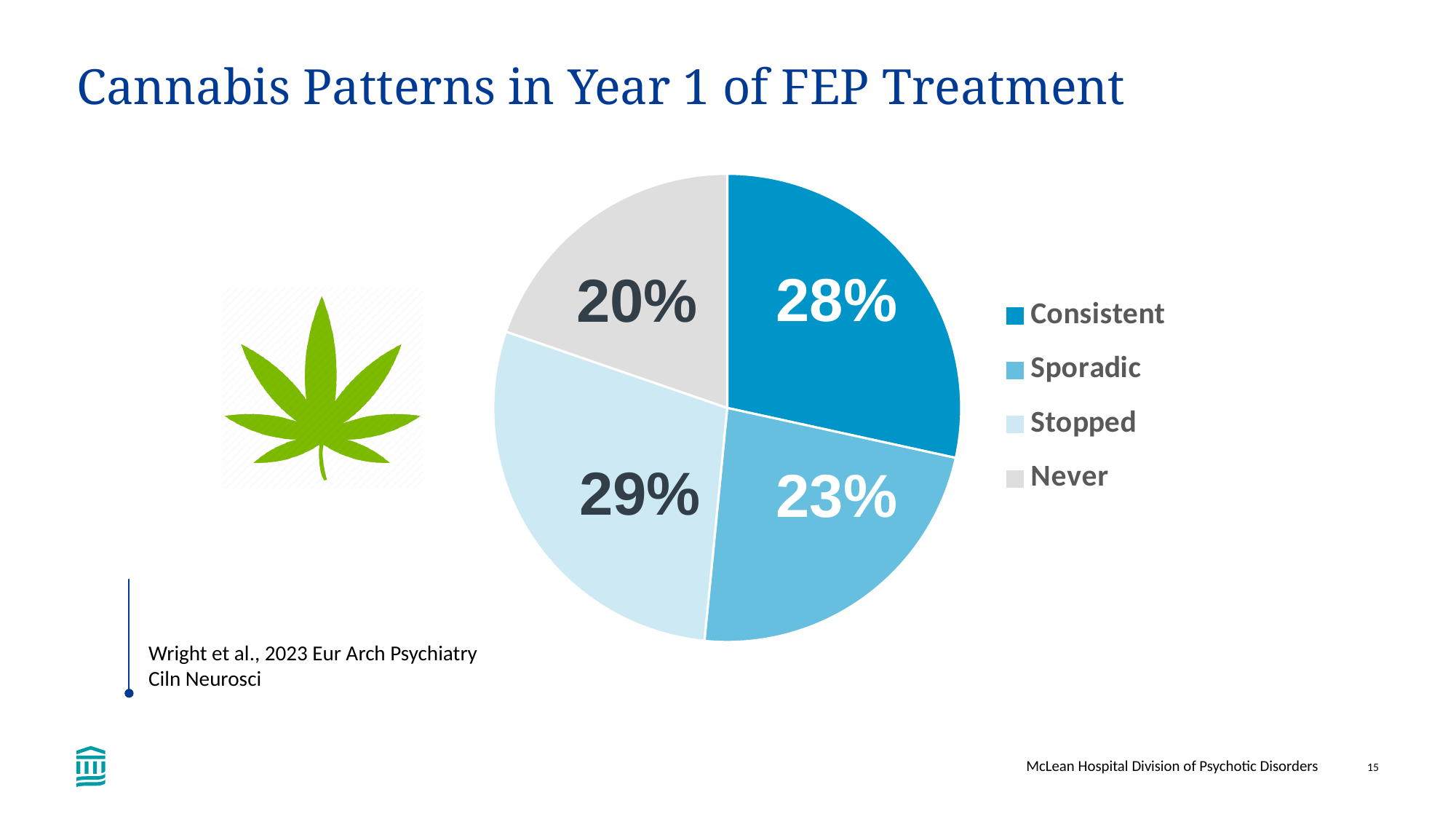
What percentage of the pie is labelled Consistent? 28% How many slices does the pie chart have? 4 What kind of chart is shown on the slide? Pie chart What percentage of the pie is labelled Sporadic? 23% What is the difference in percentage points between the Stopped and Never slices? 9 Which category has the smallest share of the pie? Never What is the combined share of the Consistent and Sporadic slices? 51% Which category has the largest share of the pie? Stopped Which is larger, the Consistent slice or the Sporadic slice? Consistent What percentage of the pie is labelled Never? 20% What percentage of the pie is labelled Stopped? 29% Which legend entry is shown in grey? Never